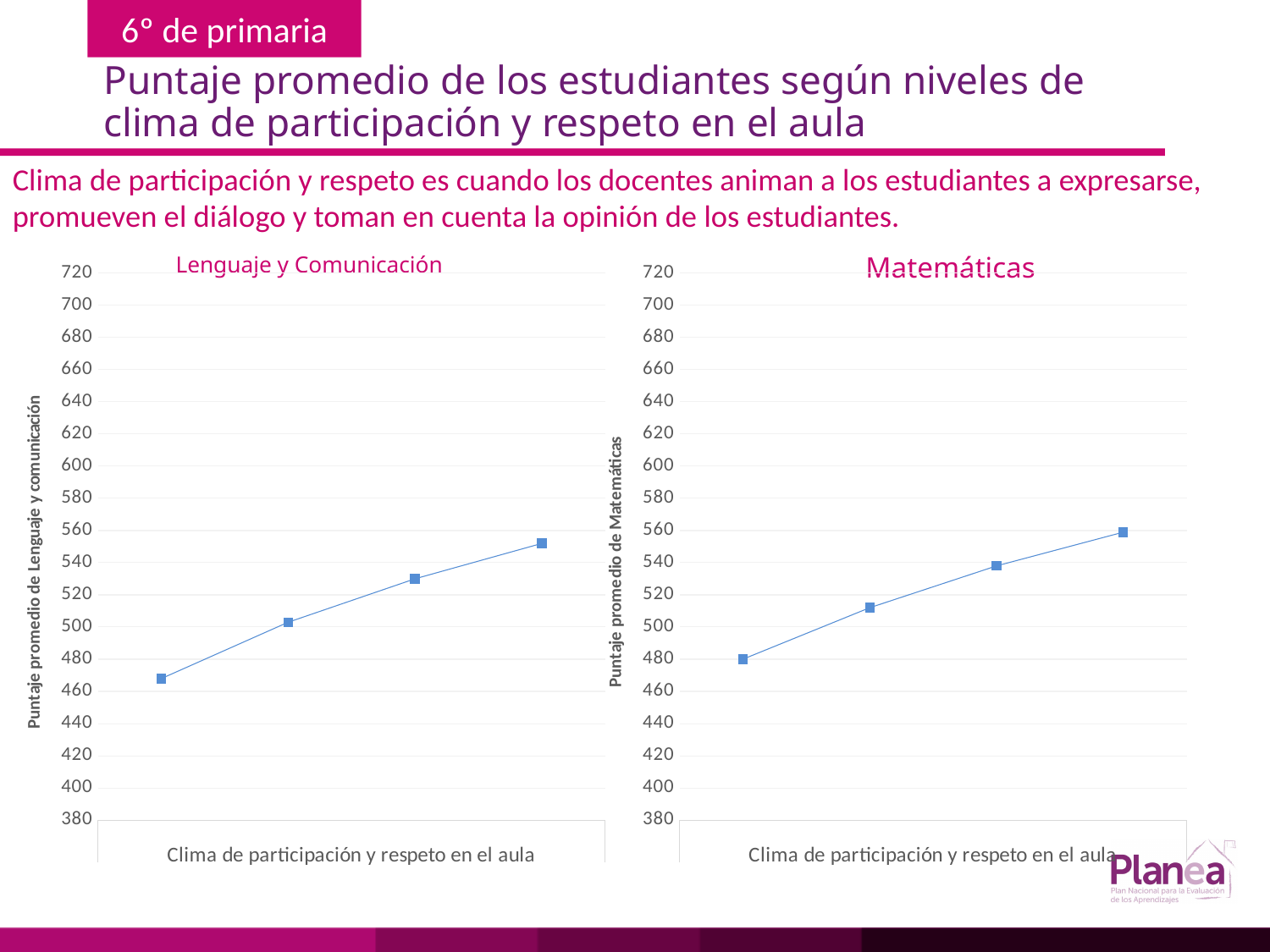
What is the x-axis title of the Lenguaje y Comunicación chart? Clima de participación y respeto en el aula In the Matemáticas chart, is the value of the leftmost point greater or less than 500? less How many data points are plotted in the Matemáticas chart? 4 What kind of chart is the Matemáticas chart? line chart In the Matemáticas chart, which point has the highest value, the leftmost or the rightmost? the rightmost In the Matemáticas chart, do the values rise or fall from left to right along the x axis? rise In the Matemáticas chart, is the value of the rightmost point greater or less than 540? greater In the Lenguaje y Comunicación chart, is the value of the rightmost point greater or less than 540? greater What kind of chart is the Lenguaje y Comunicación chart? line chart How many data points are plotted in the Lenguaje y Comunicación chart? 4 In the Lenguaje y Comunicación chart, do the values rise or fall from left to right along the x axis? rise